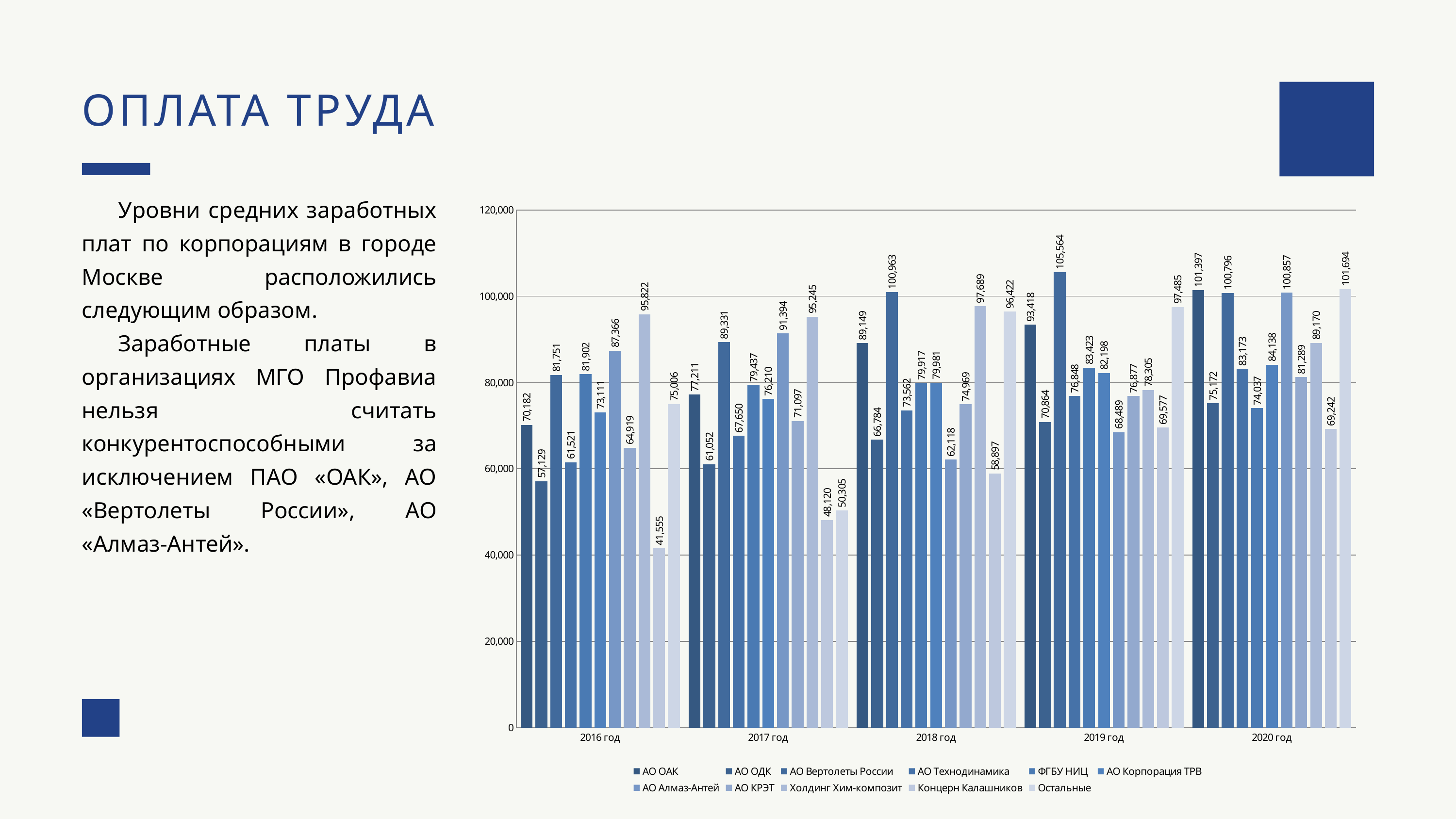
What is the lowest value shown anywhere on the chart? 41,555 Which is larger for АО ОДК: the value in 2016 год or in 2017 год? 2017 год What is the value for АО ОДК in 2019 год? 70,864 What is the value for АО ОАК in 2020 год? 101,397 What kind of chart is shown on the slide? bar chart What is the value for АО ОАК in 2016 год? 70,182 How many year groups are shown on the x axis of the chart? 5 What is the highest value shown anywhere on the chart? 105,564 How many series does the chart legend list? 11 What is the value for АО Вертолеты России in 2017 год? 89,331 By how much did the value for АО ОАК increase from 2016 год to 2020 год? 31,215 Do the values for АО ОАК rise or fall from 2016 год to 2020 год? rise